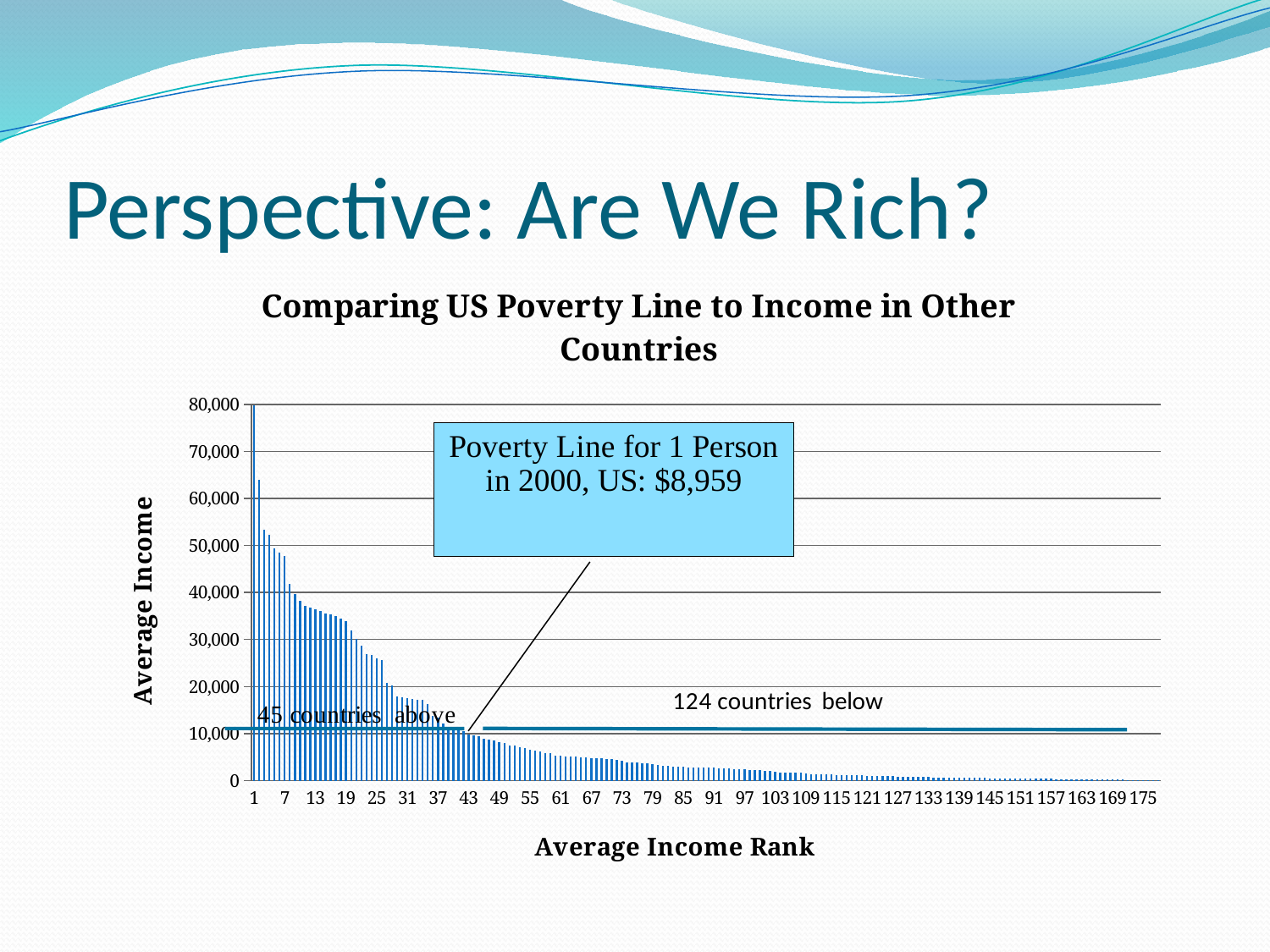
What is the title of the chart? Comparing US Poverty Line to Income in Other Countries According to the annotation on the chart, how many countries are above the US poverty line? 45 countries According to the annotation on the chart, how many countries are below the US poverty line? 124 countries What kind of chart is shown on the slide? bar chart According to the callout on the chart, what was the poverty line for 1 person in the US in 2000? $8,959 What is the label of the vertical axis of the chart? Average Income Is the average income for rank 103 greater or less than 10,000? less Is the average income for rank 1 greater or less than 70,000? greater Do the average income values rise or fall as the average income rank increases along the x axis? fall Which average income rank has the highest average income? 1 Which has the larger average income, rank 13 or rank 61? rank 13 Is the average income for rank 7 greater or less than 40,000? greater